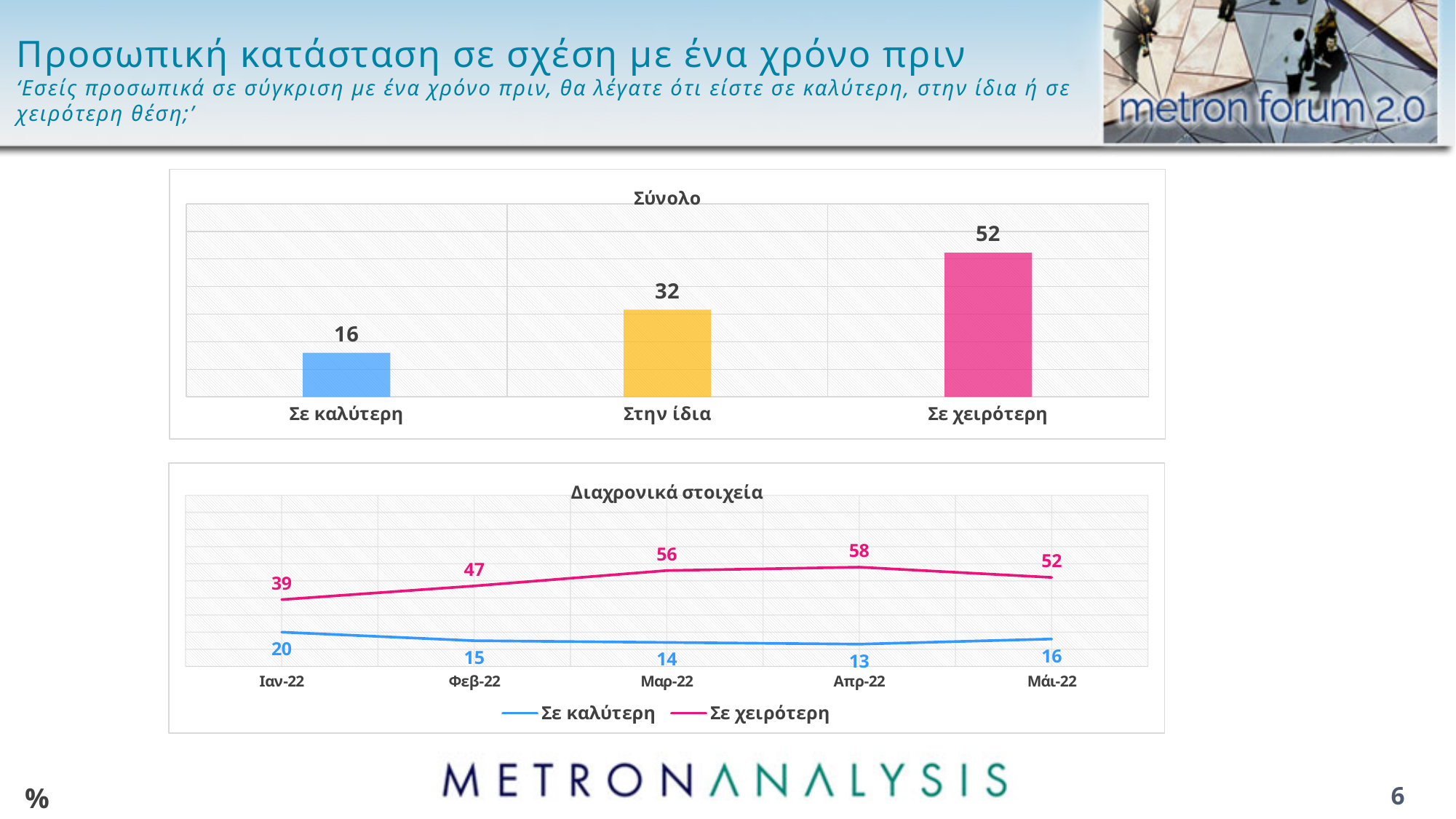
In the 'Διαχρονικά στοιχεία' chart, what is the difference between 'Σε χειρότερη' and 'Σε καλύτερη' in Ιαν-22? 19 In the 'Διαχρονικά στοιχεία' chart, what is the value for 'Σε χειρότερη' in Απρ-22? 58 In the 'Διαχρονικά στοιχεία' chart, does 'Σε χειρότερη' rise or fall from Ιαν-22 to Απρ-22? Rise In the 'Σύνολο' chart, how many categories are shown? 3 In the 'Διαχρονικά στοιχεία' chart, in which month is 'Σε χειρότερη' highest? Απρ-22 In the 'Διαχρονικά στοιχεία' chart, how many series does the legend list? 2 What kind of chart is the 'Σύνολο' chart? Bar chart In the 'Σύνολο' chart, what is the difference between 'Σε χειρότερη' and 'Στην ίδια'? 20 In the 'Σύνολο' chart, which category has the lowest value? Σε καλύτερη In the 'Διαχρονικά στοιχεία' chart, in which month is 'Σε καλύτερη' lowest? Απρ-22 In the 'Σύνολο' chart, what is the value for 'Σε χειρότερη'? 52 In the 'Διαχρονικά στοιχεία' chart, what is the value for 'Σε καλύτερη' in Φεβ-22? 15